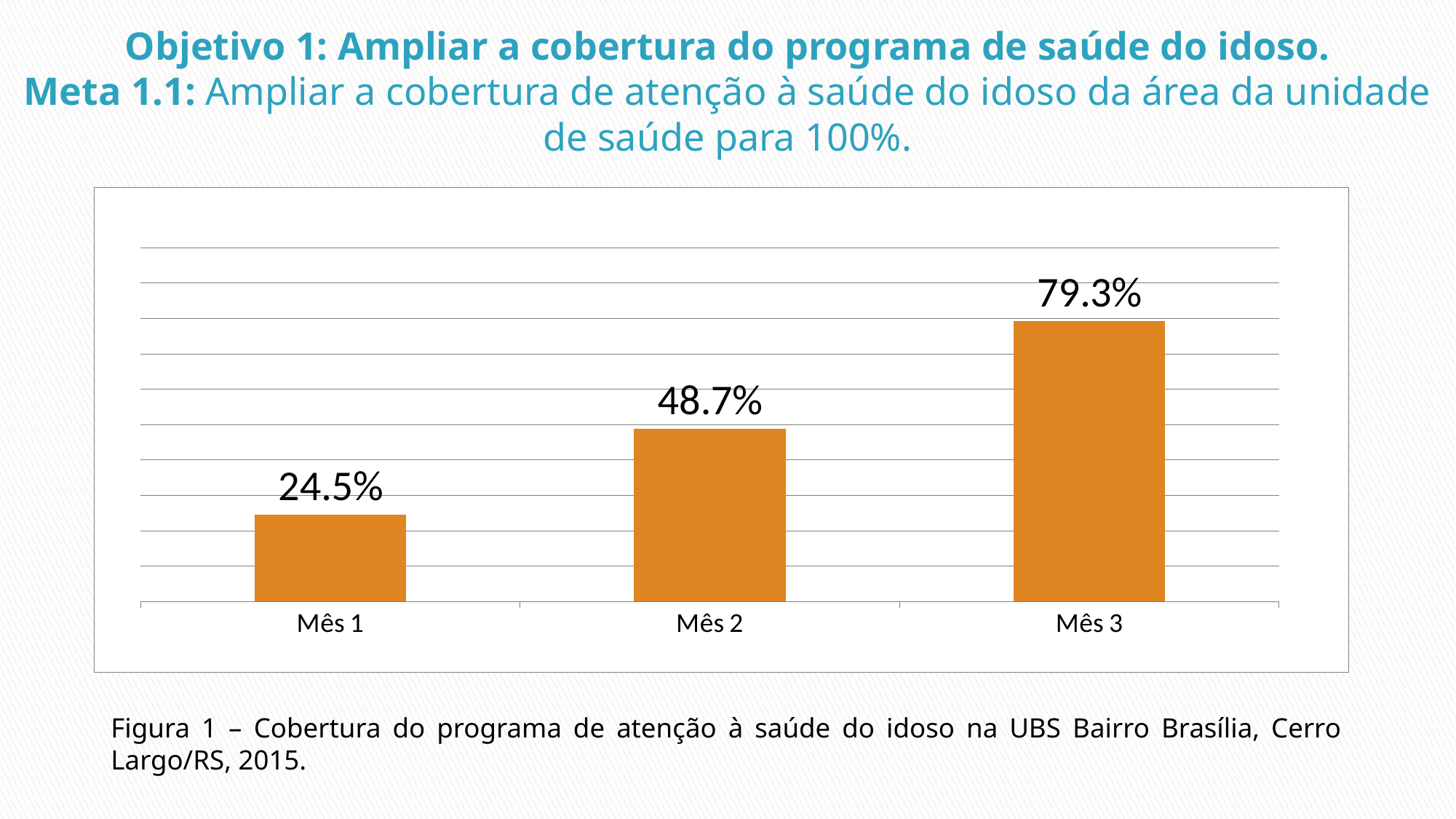
How many categories (months) are shown on the chart? 3 What colour are the bars in the chart? Orange What is the difference between the values for Mês 2 and Mês 1? 24.2% What kind of chart is shown on the slide? Bar chart Do the values rise or fall from Mês 1 to Mês 3? Rise Which month has the highest coverage value? Mês 3 What is the difference between the values for Mês 3 and Mês 1? 54.8% What is the value for Mês 3? 79.3% What is the value for Mês 1? 24.5% Which month has the lowest coverage value? Mês 1 Which is larger, the value for Mês 2 or the value for Mês 3? Mês 3 What is the value for Mês 2? 48.7%